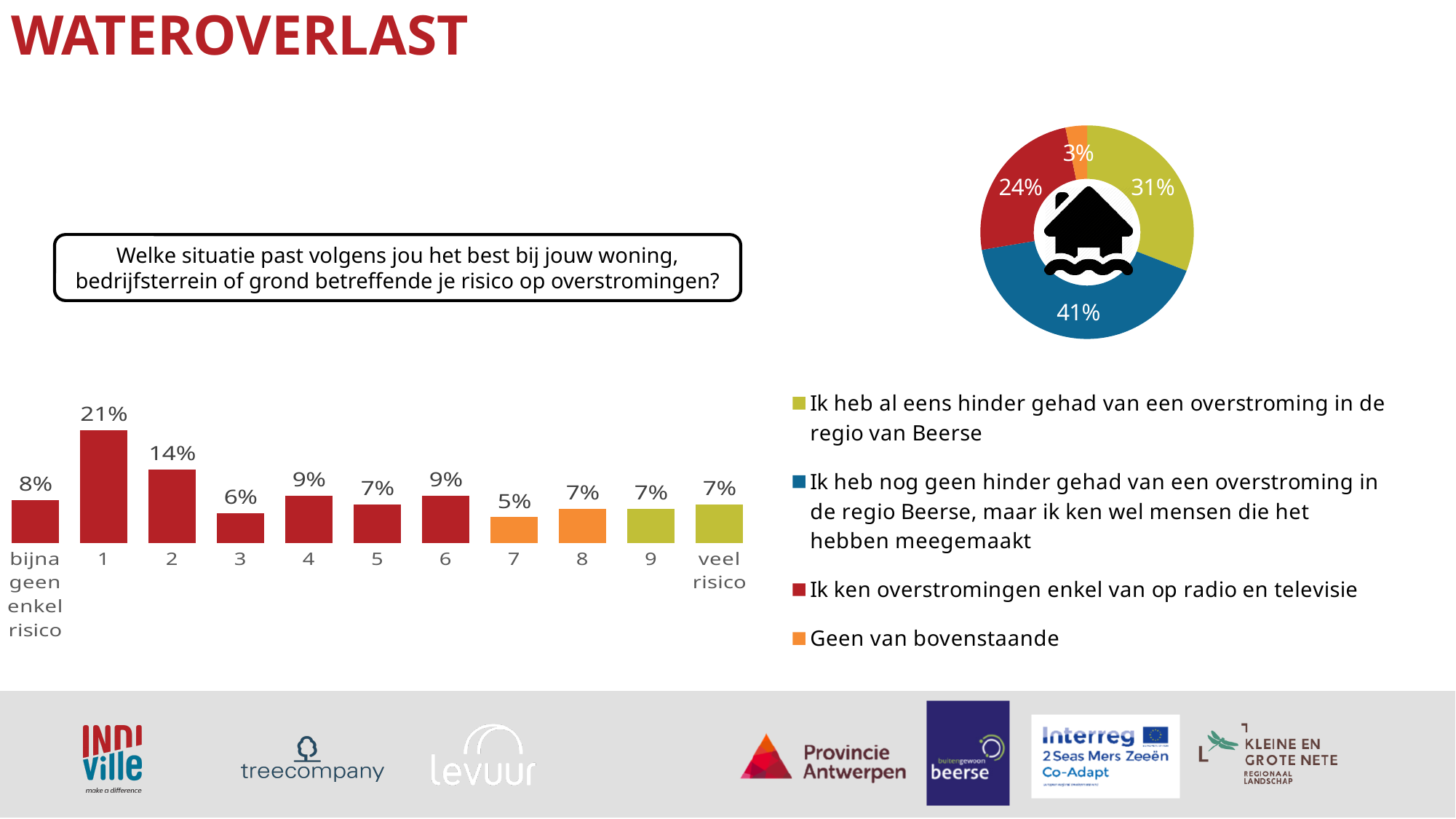
In the bar chart on the left, which category has the lowest value? 7 In the pie chart on the right, which legend entry has the largest slice? Ik heb nog geen hinder gehad van een overstroming in de regio Beerse, maar ik ken wel mensen die het hebben meegemaakt How many entries does the legend of the pie chart on the right list? 4 How many categories does the bar chart on the left show? 11 In the bar chart on the left, what is the value for 'bijna geen enkel risico'? 8% In the pie chart on the right, what share does the slice for 'Ik heb nog geen hinder gehad van een overstroming in de regio Beerse, maar ik ken wel mensen die het hebben meegemaakt' have? 41% In the bar chart on the left, which category has the highest value? 1 What kind of chart is the chart on the left of the slide? bar chart In the bar chart on the left, what is the value for category 1? 21% In the bar chart on the left, what is the difference between the values for category 1 and category 2? 7% In the pie chart on the right, what share does the slice for 'Geen van bovenstaande' have? 3% In the bar chart on the left, which is larger: the value for category 4 or the value for category 3? 4